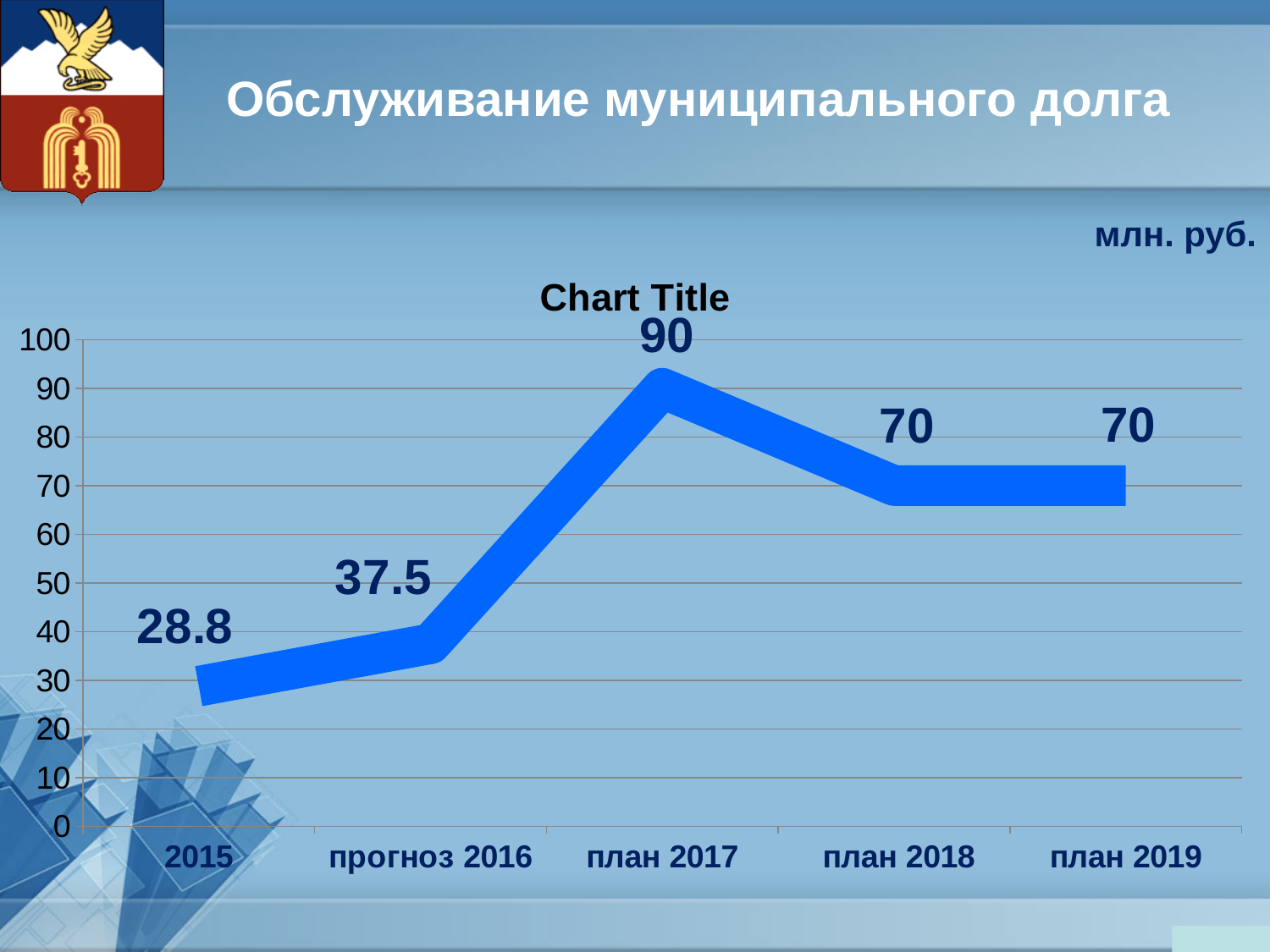
What is the value for прогноз 2016? 37.5 What is the difference between the values for прогноз 2016 and 2015? 8.7 What is the difference between the values for план 2017 and план 2018? 20 Which category has the lowest value? 2015 What is the value for план 2019? 70 Which category has the highest value? план 2017 What is the value for план 2017? 90 Which is larger, the value for прогноз 2016 or the value for план 2018? план 2018 What is the value for 2015? 28.8 How many categories are shown on the x axis? 5 What kind of chart is shown on the slide? line chart What unit is stated above the chart? млн. руб.